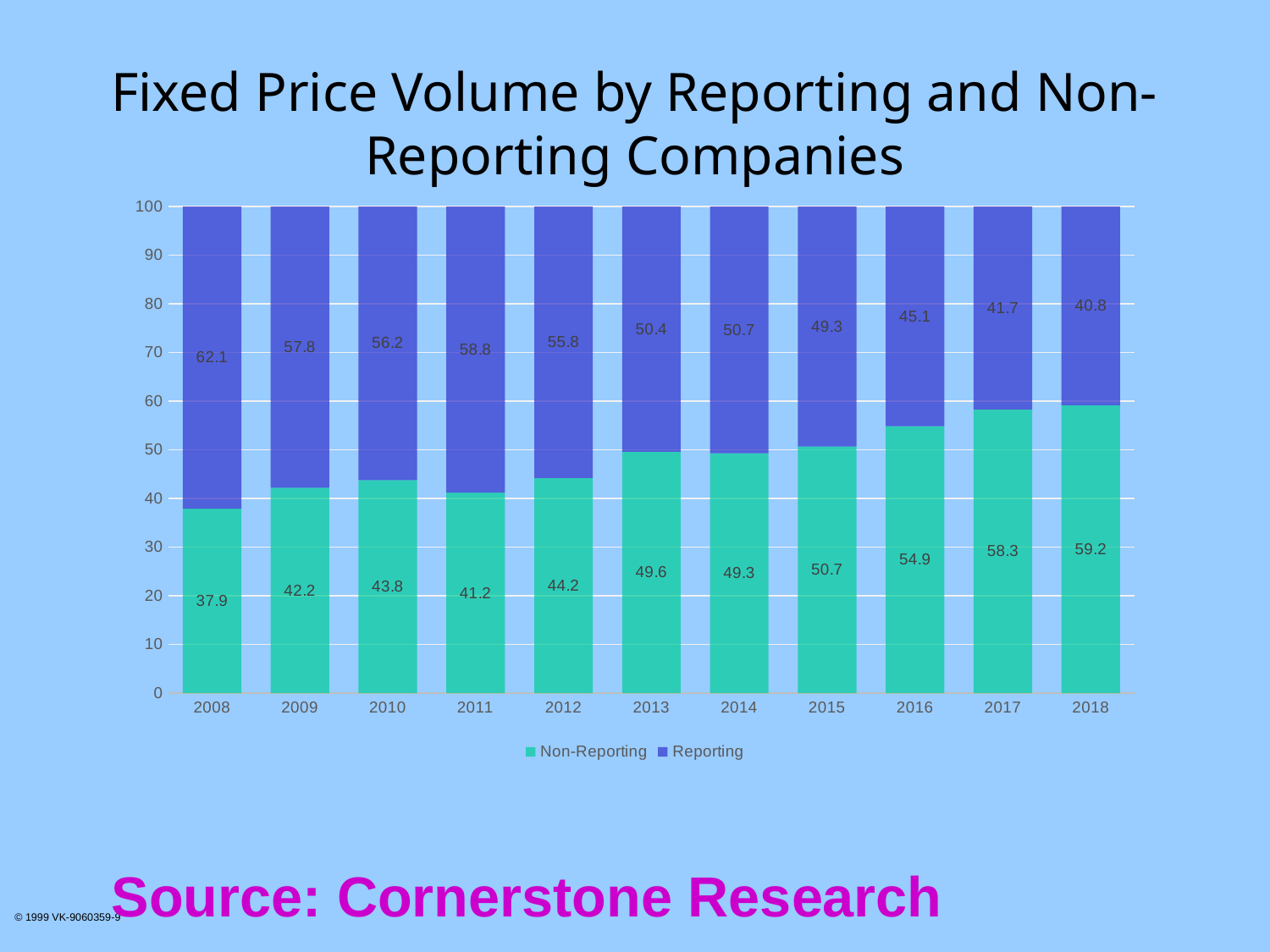
Does the Non-Reporting value generally rise or fall from 2008 to 2018? Rise Which is larger in 2011, the Non-Reporting value or the Reporting value? Reporting How many years are shown on the x axis? 11 Which year has the highest Non-Reporting value? 2018 What is the Non-Reporting value for 2008? 37.9 What is the Reporting value for 2016? 45.1 What kind of chart is shown on the slide? Stacked bar chart Which year has the lowest Reporting value? 2018 What is the difference between the Reporting value in 2008 and the Reporting value in 2018? 21.3 What is the title of the chart? Fixed Price Volume by Reporting and Non-Reporting Companies What is the total of the stacked bar for 2015? 100 How many series does the legend list? 2